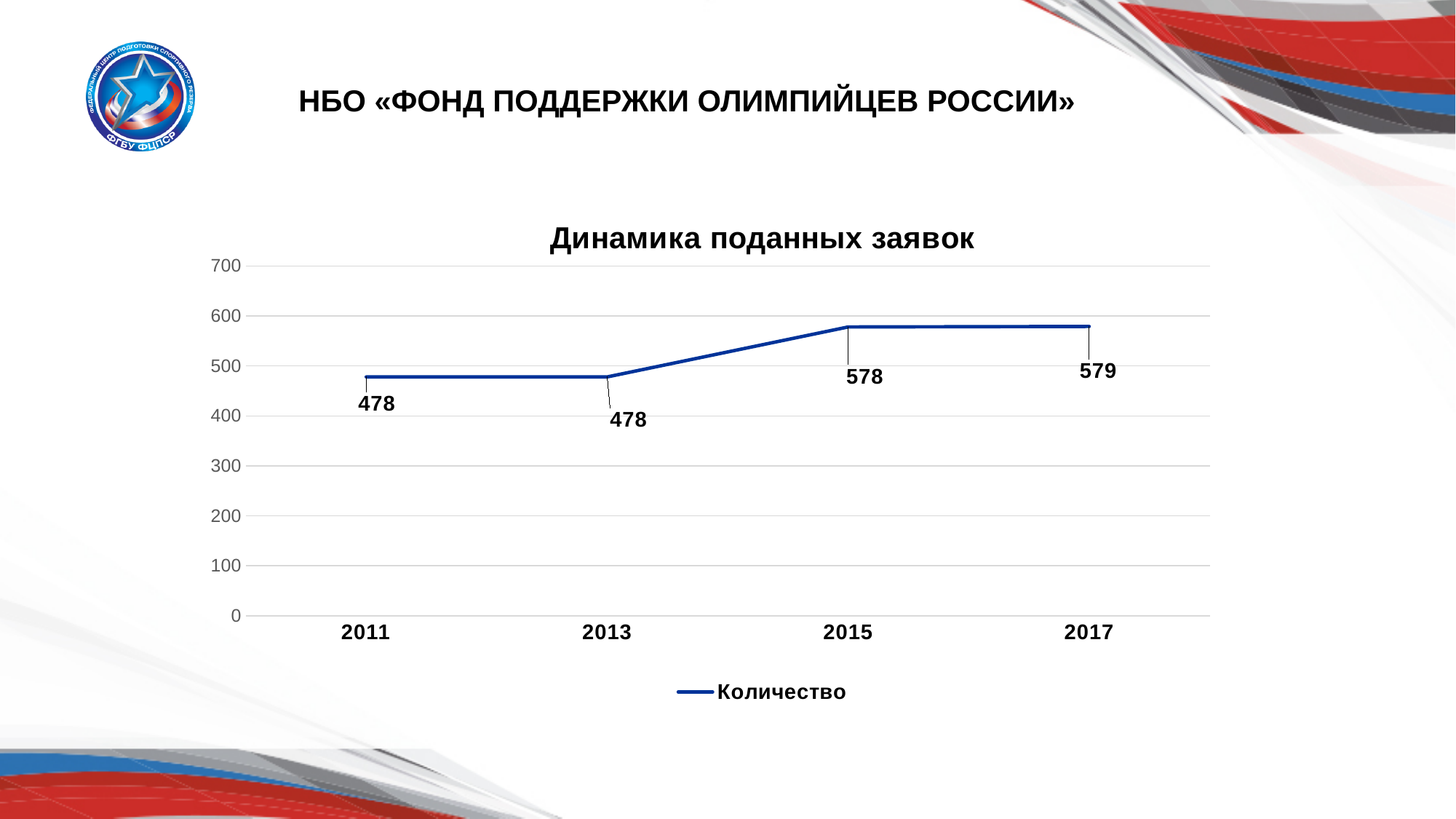
What is the value for 2011? 478 What is the value for 2015? 578 What is the difference between the values for 2015 and 2013? 100 How many series does the legend list? 1 How many years are plotted on the x axis? 4 What is the value for 2017? 579 Is the value for 2017 greater or less than 500? greater Which year has the highest value? 2017 Which is larger, the value for 2013 or the value for 2015? 2015 What is the difference between the values for 2017 and 2011? 101 What kind of chart is shown? line chart What is the title of the chart? Динамика поданных заявок